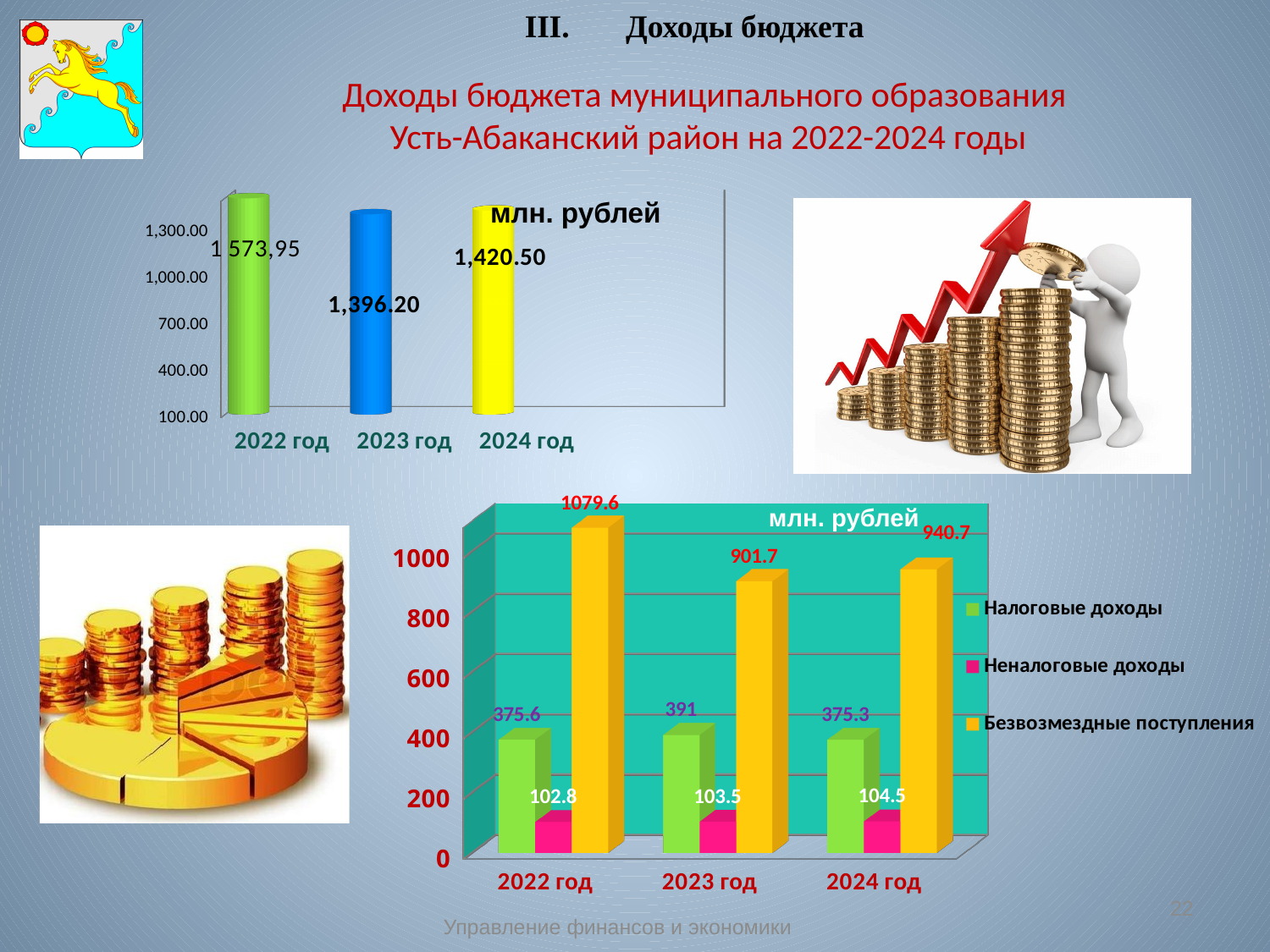
In the bottom chart, what is the value of Налоговые доходы for 2023 год? 391 In the bottom chart, what is the value of Безвозмездные поступления for 2022 год? 1079.6 In the top-left chart, which year has the highest value? 2022 год What kind of chart is the bottom chart? bar chart In the bottom chart, what is the value of Неналоговые доходы for 2024 год? 104.5 In the top-left chart, how many years are shown? 3 In the top-left chart, which year has the lowest value? 2023 год In the bottom chart, what is the difference between Безвозмездные поступления in 2024 год and 2023 год? 39 In the top-left chart, what is the value for 2024 год? 1,420.50 In the bottom chart, how many series does the legend list? 3 In the top-left chart, what is the value for 2023 год? 1,396.20 In the bottom chart, which year has the highest value for Безвозмездные поступления? 2022 год